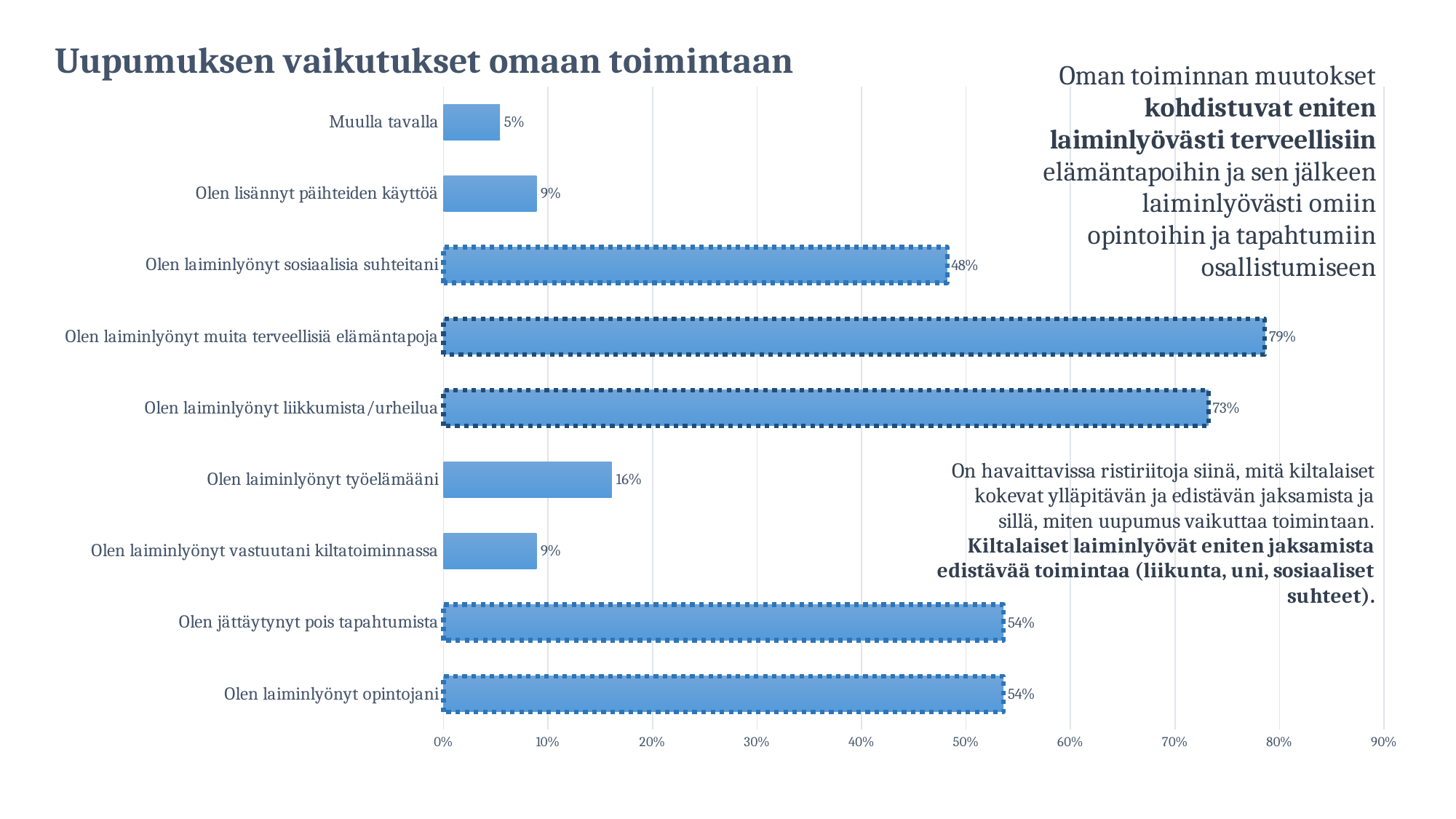
Which is larger: the value for "Olen laiminlyönyt sosiaalisia suhteitani" or the value for "Olen jättäytynyt pois tapahtumista"? Olen jättäytynyt pois tapahtumista What kind of chart is shown on the slide? bar chart What is the difference between the values for "Olen laiminlyönyt muita terveellisiä elämäntapoja" and "Olen laiminlyönyt liikkumista/urheilua"? 6% What is the value for "Olen laiminlyönyt työelämääni"? 16% What is the title of the chart? Uupumuksen vaikutukset omaan toimintaan What is the value for "Olen lisännyt päihteiden käyttöä"? 9% What is the value for "Olen laiminlyönyt sosiaalisia suhteitani"? 48% What is the value for "Olen laiminlyönyt muita terveellisiä elämäntapoja"? 79% How many categories are shown in the chart? 9 Which category has the highest value? Olen laiminlyönyt muita terveellisiä elämäntapoja Which category has the lowest value? Muulla tavalla Is the value for "Olen laiminlyönyt liikkumista/urheilua" greater or less than 60%? greater